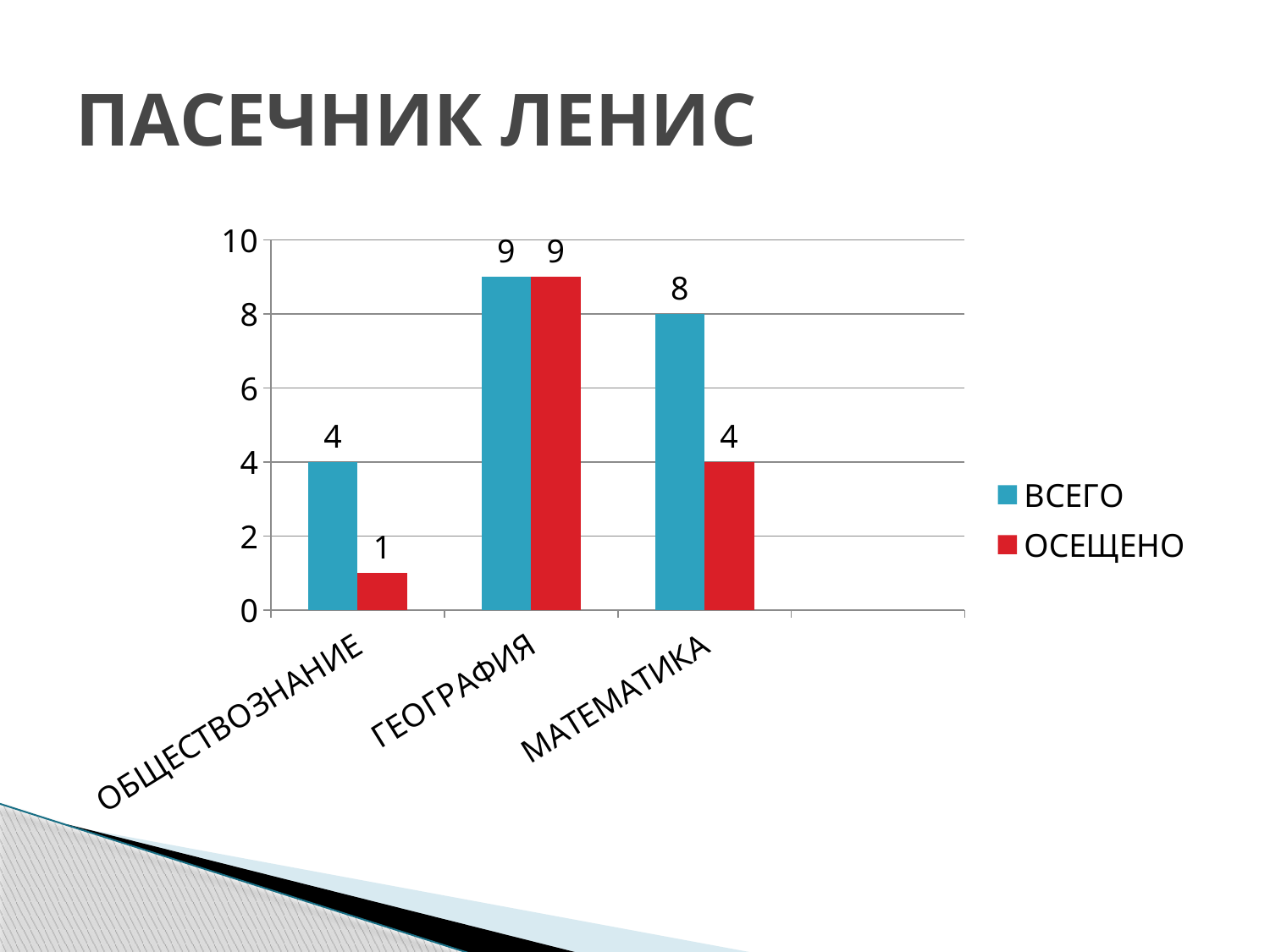
What is the ОСЕЩЕНО value for ОБЩЕСТВОЗНАНИЕ? 1 What is the ОСЕЩЕНО value for МАТЕМАТИКА? 4 What is the difference between the ВСЕГО and ОСЕЩЕНО values for МАТЕМАТИКА? 4 Which category has the highest ВСЕГО value? ГЕОГРАФИЯ What is the ВСЕГО value for ОБЩЕСТВОЗНАНИЕ? 4 What is the ВСЕГО value for ГЕОГРАФИЯ? 9 Which is larger for ОБЩЕСТВОЗНАНИЕ, the ВСЕГО value or the ОСЕЩЕНО value? ВСЕГО What kind of chart is shown on the slide? Bar chart How many series does the legend list? 2 How many categories are shown on the x axis? 3 Which category has the lowest ОСЕЩЕНО value? ОБЩЕСТВОЗНАНИЕ What colour are the ОСЕЩЕНО bars? Red